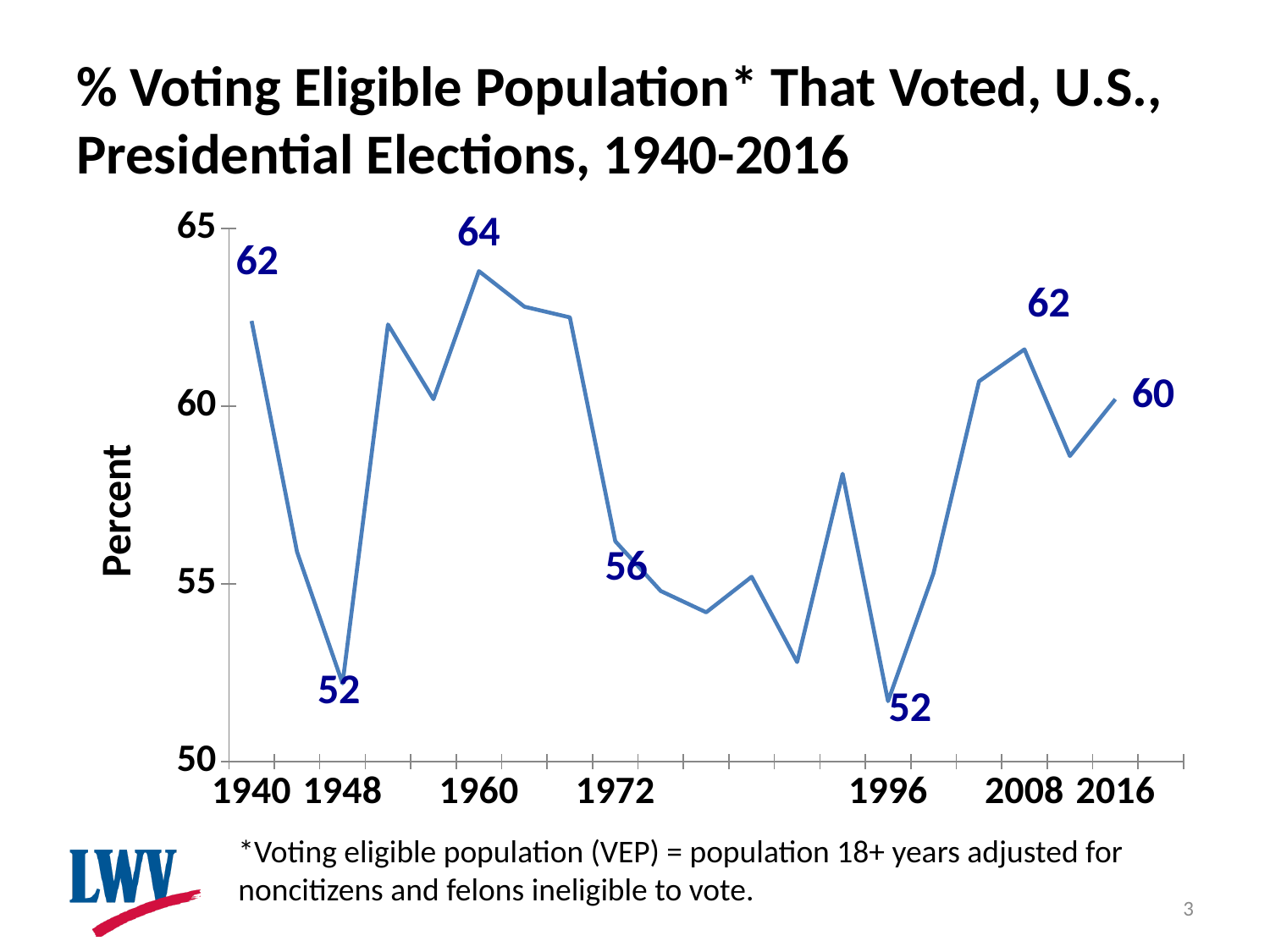
Which year has the larger value, 1940 or 2016? 1940 What is the difference between the values for 2008 and 2016? 2 Which labeled year has the highest turnout value on the chart? 1960 What is the value shown for 2016? 60 What type of chart is shown on the slide? Line chart Is the value for 1996 greater or less than 55? less What is the value shown for 1972? 56 What is the difference between the values for 1960 and 1948? 12 What percentage of the voting eligible population voted in 1960? 64 Does the line rise or fall between 1996 and 2008? Rises What is the lowest value labeled on the chart? 52 What is the title of the vertical axis? Percent